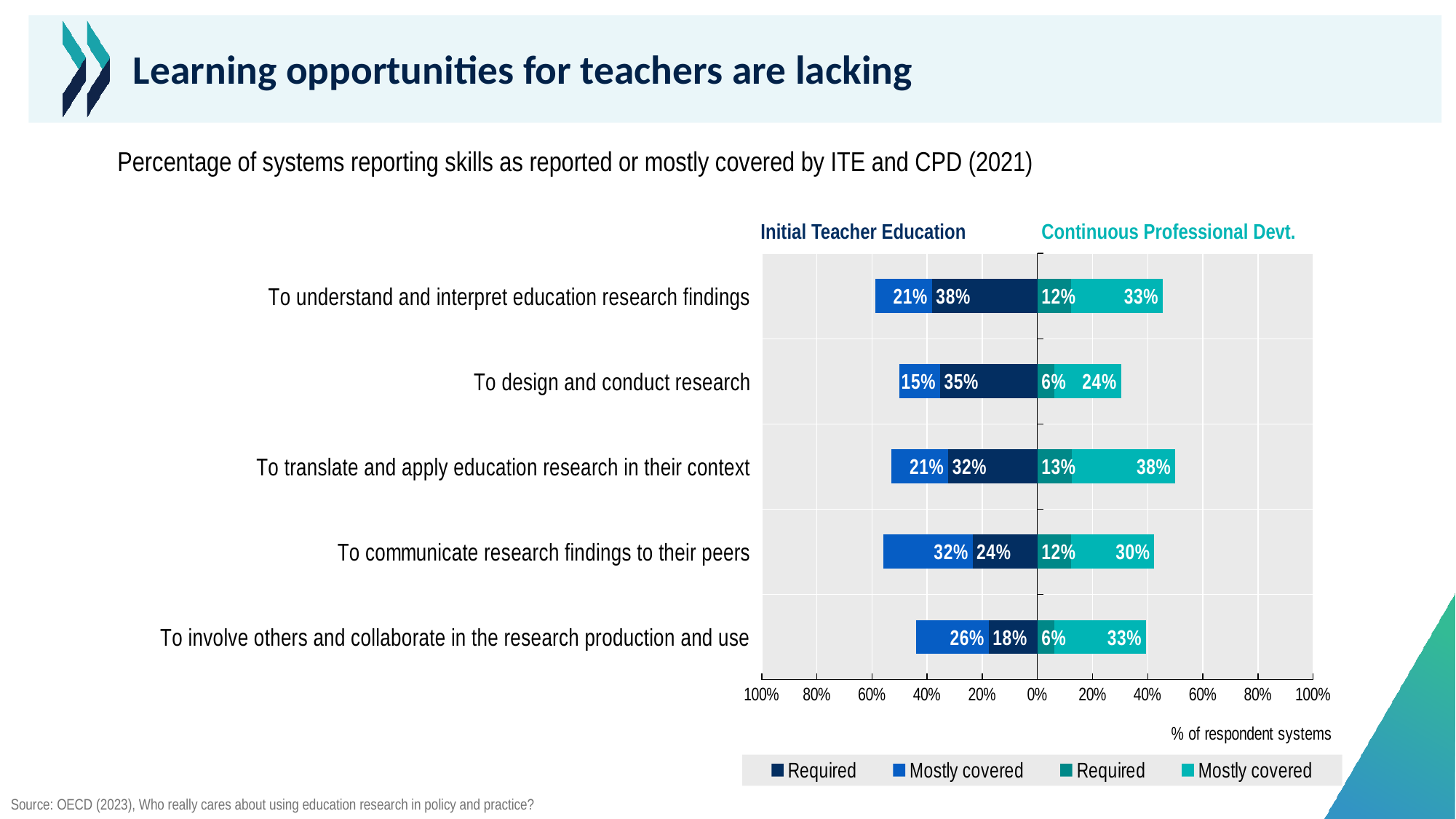
What type of chart is shown on the slide? bar chart What is the Continuous Professional Devt. 'Required' value for 'To design and conduct research'? 6% What is the total Initial Teacher Education bar (Required plus Mostly covered) for 'To involve others and collaborate in the research production and use'? 44% How many series does the chart legend list? 4 What is the Initial Teacher Education 'Required' value for 'To understand and interpret education research findings'? 38% Which skill has the lowest Continuous Professional Devt. 'Mostly covered' value? To design and conduct research What is the total Continuous Professional Devt. bar (Required plus Mostly covered) for 'To translate and apply education research in their context'? 51% Which side of the chart is labelled in teal: Initial Teacher Education or Continuous Professional Devt.? Continuous Professional Devt. What is the difference between the Initial Teacher Education 'Required' values for 'To understand and interpret education research findings' and 'To involve others and collaborate in the research production and use'? 20% What is the Initial Teacher Education 'Mostly covered' value for 'To communicate research findings to their peers'? 32% What is the Continuous Professional Devt. 'Mostly covered' value for 'To translate and apply education research in their context'? 38% How many skill categories are plotted in the chart? 5